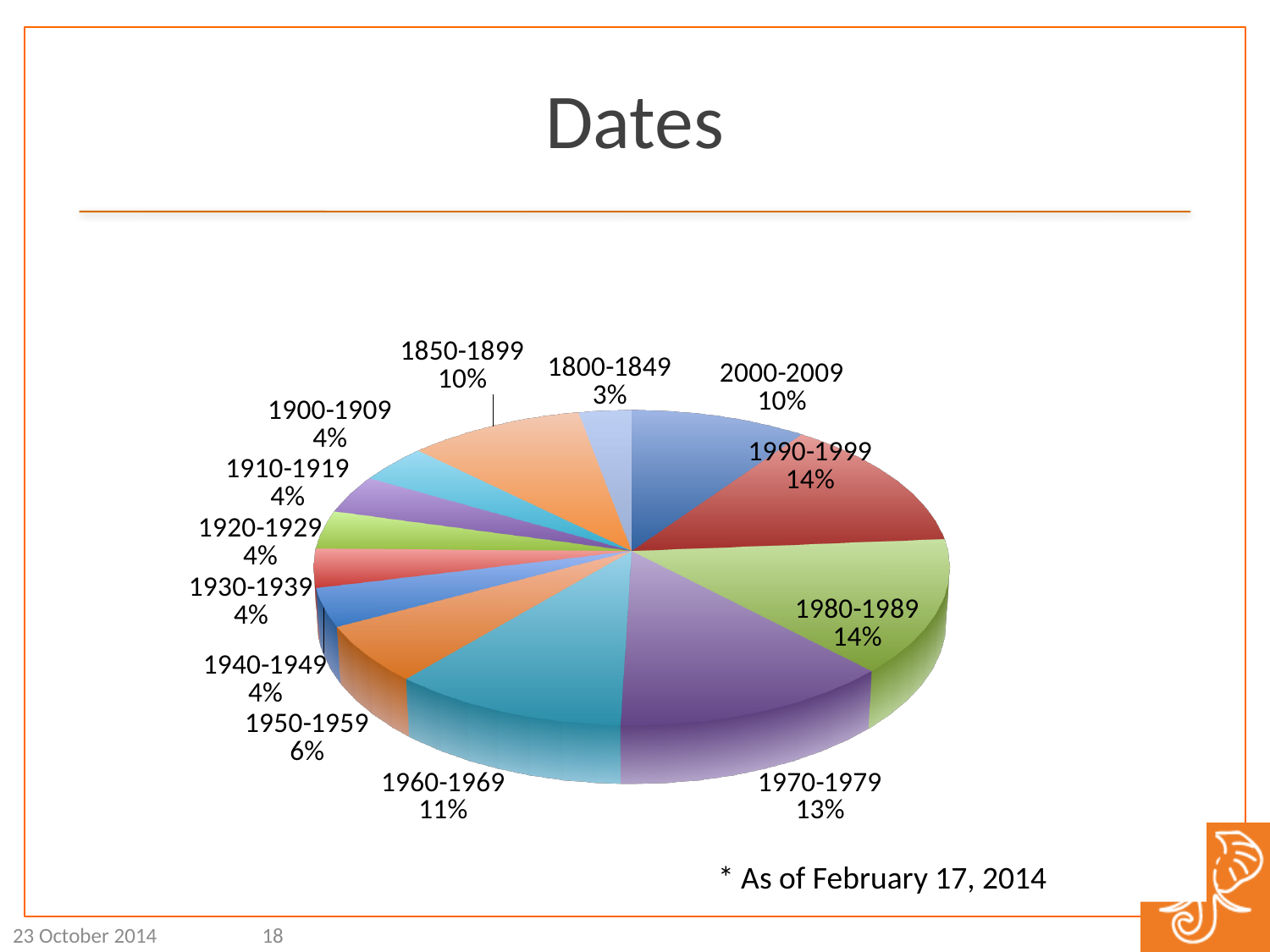
What share of the pie does the 1970-1979 slice represent? 13% What kind of chart is shown on the slide? pie chart What is the difference in percentage points between 1980-1989 and 1950-1959? 8 What percentage is shown for 1850-1899? 10% What percentage is shown for 1990-1999? 14% Which is larger, the slice for 1970-1979 or the slice for 2000-2009? 1970-1979 What is the title of the slide containing the pie chart? Dates What percentage is shown for 1950-1959? 6% How many slices does the pie chart have? 13 What is the difference in percentage points between 1960-1969 and 1800-1849? 8 Which date range has the smallest slice of the pie? 1800-1849 What percentage is shown for 1960-1969? 11%